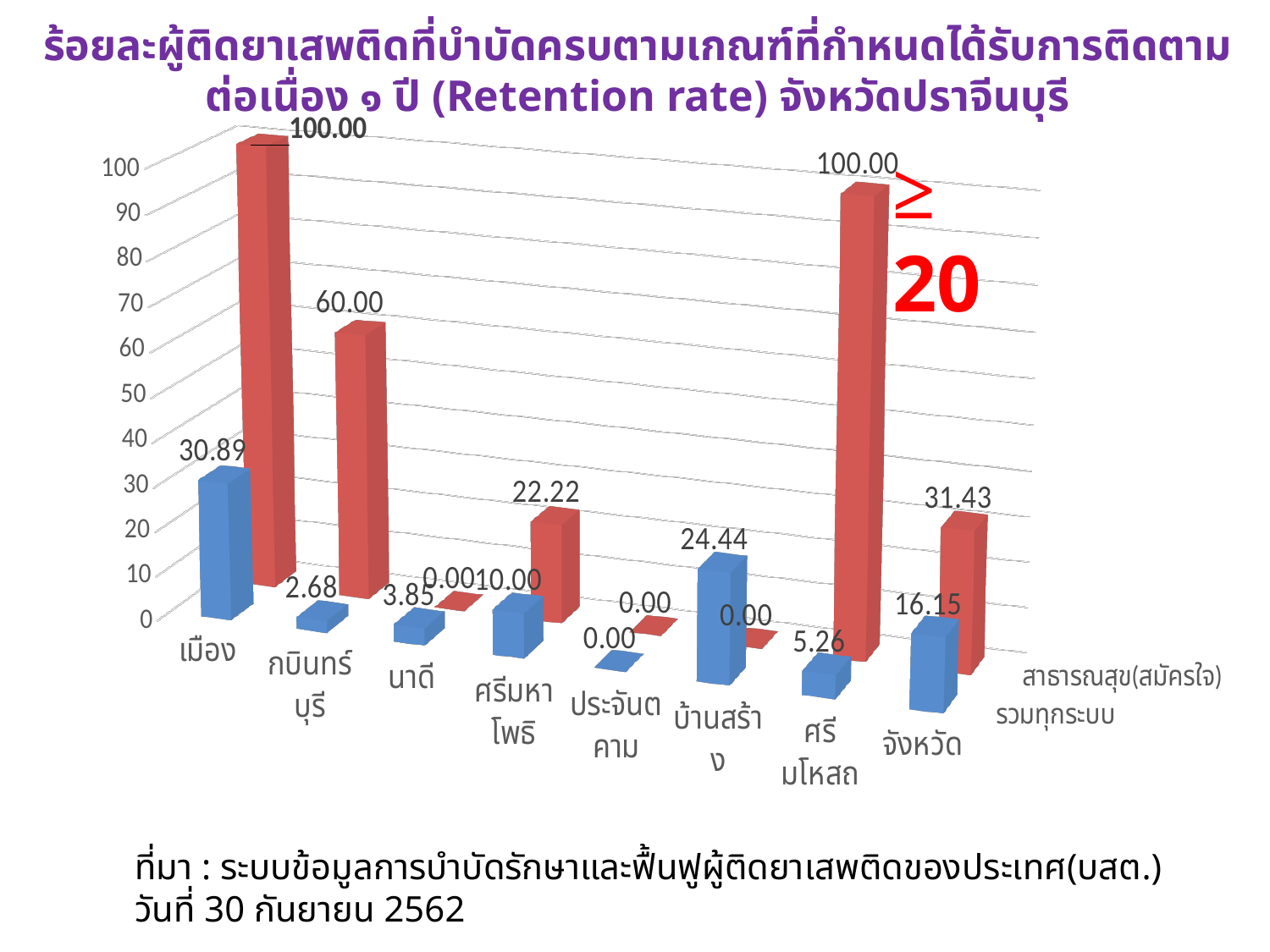
How many categories (districts/province) are shown along the x axis of the chart? 8 What is the value of the red (สาธารณสุข(สมัครใจ)) bar for กบินทร์บุรี? 60.00 What type of chart is shown on the slide? bar chart What is the difference between the red (สาธารณสุข(สมัครใจ)) and blue (รวมทุกระบบ) values for จังหวัด? 15.28 What is the red number shown to the right of the ศรีมโหสถ bar as the target threshold? ≥ 20 What is the value of the blue (รวมทุกระบบ) bar for ศรีมโหสถ? 5.26 Which category has the highest value in the blue (รวมทุกระบบ) series? เมือง Which category has the lowest value in the blue (รวมทุกระบบ) series? ประจันตคาม What is the value of the blue (รวมทุกระบบ) bar for บ้านสร้าง? 24.44 What is the value of the red (สาธารณสุข(สมัครใจ)) bar for จังหวัด? 31.43 Which is larger for ศรีมหาโพธิ: the blue (รวมทุกระบบ) value or the red (สาธารณสุข(สมัครใจ)) value? red (สาธารณสุข(สมัครใจ)) What is the value of the blue (รวมทุกระบบ) bar for เมือง? 30.89